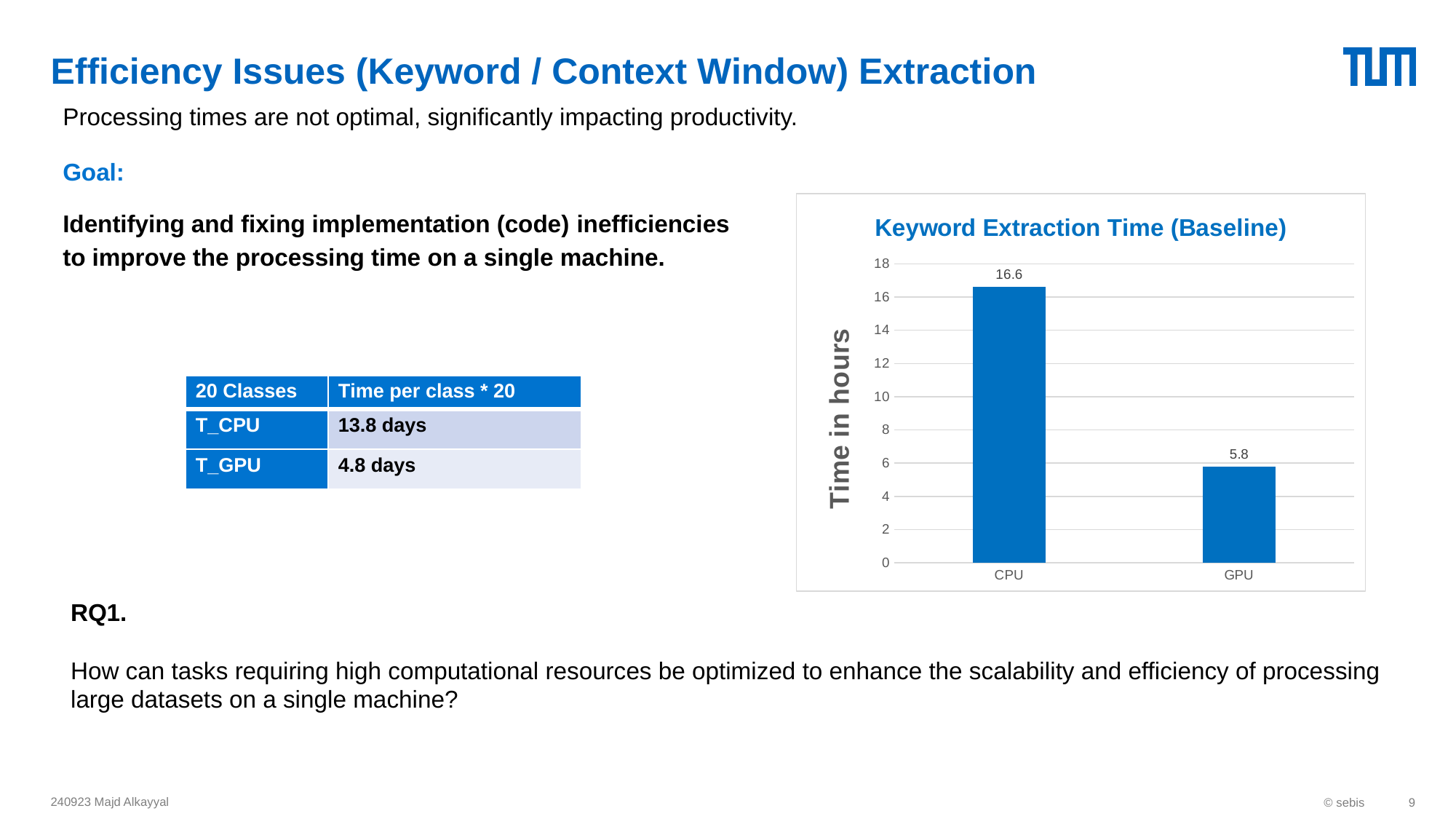
What is the value for GPU in the Keyword Extraction Time (Baseline) chart? 5.8 What is the y-axis label of the Keyword Extraction Time (Baseline) chart? Time in hours Which category has the highest value in the Keyword Extraction Time (Baseline) chart? CPU In the Keyword Extraction Time (Baseline) chart, is the value for CPU or GPU larger? CPU What is the value for CPU in the Keyword Extraction Time (Baseline) chart? 16.6 How many categories are shown in the Keyword Extraction Time (Baseline) chart? 2 What is the difference between the CPU and GPU values in the Keyword Extraction Time (Baseline) chart? 10.8 What kind of chart is the Keyword Extraction Time (Baseline) chart? bar chart Which category has the lowest value in the Keyword Extraction Time (Baseline) chart? GPU What is the title of the chart on the slide? Keyword Extraction Time (Baseline) Is the value for CPU in the Keyword Extraction Time (Baseline) chart greater or less than 14? greater Is the value for GPU in the Keyword Extraction Time (Baseline) chart greater or less than 8? less